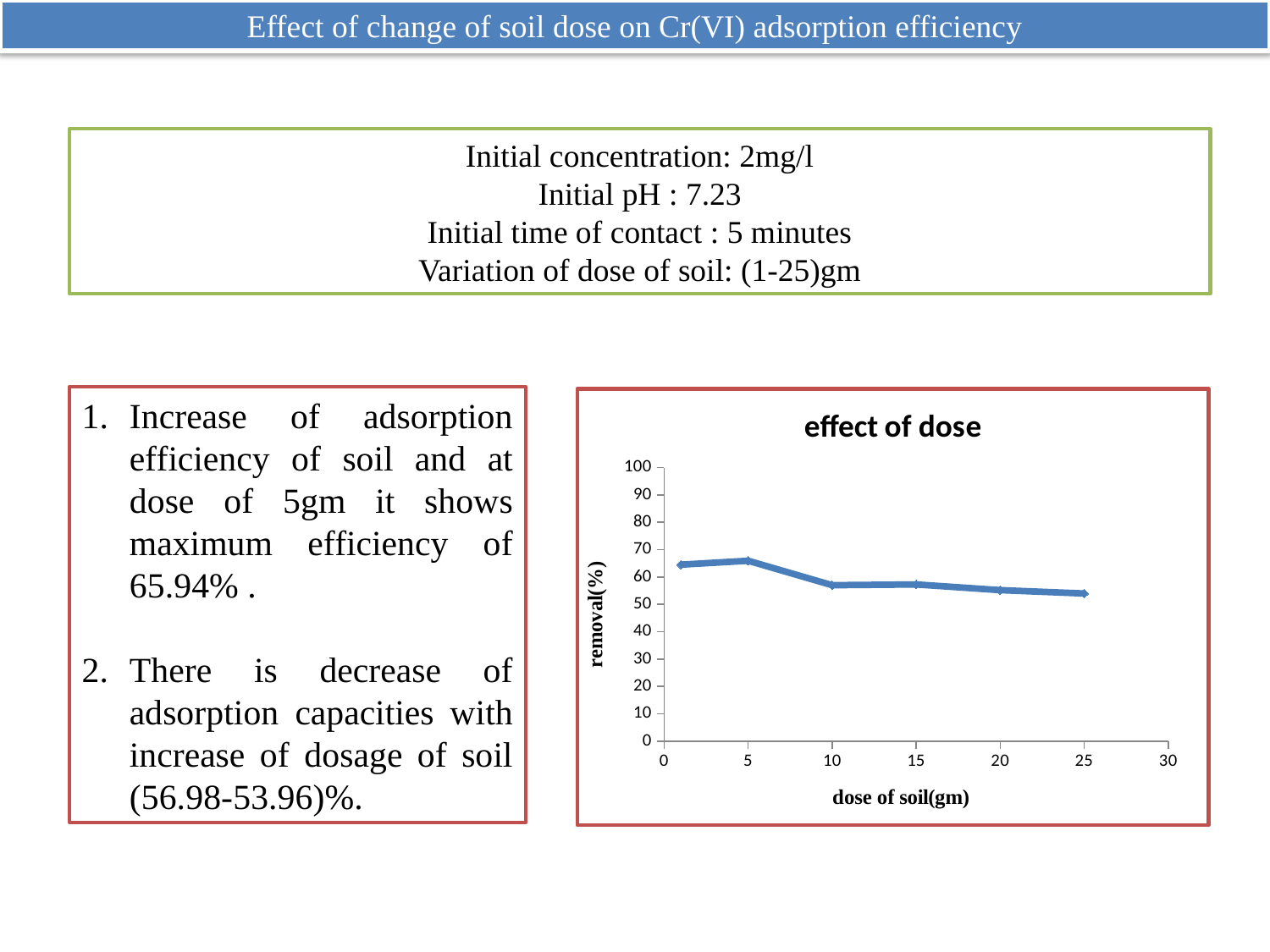
Is the removal value at a dose of 5 gm greater or less than 60? greater What is the title of the chart? effect of dose Overall, do the removal values rise or fall as the dose of soil increases along the x axis? fall At which dose of soil is the removal(%) highest? 5 Is the removal value at a dose of 1 gm greater or less than 70? less What is the label of the y axis of the chart? removal(%) Which has the higher removal(%): a dose of 5 gm or a dose of 25 gm? 5 gm How many data points are plotted on the line in the chart? 6 Is the removal value at a dose of 25 gm greater or less than 60? less Which has the higher removal(%): a dose of 1 gm or a dose of 20 gm? 1 gm What kind of chart is shown on the slide? line chart